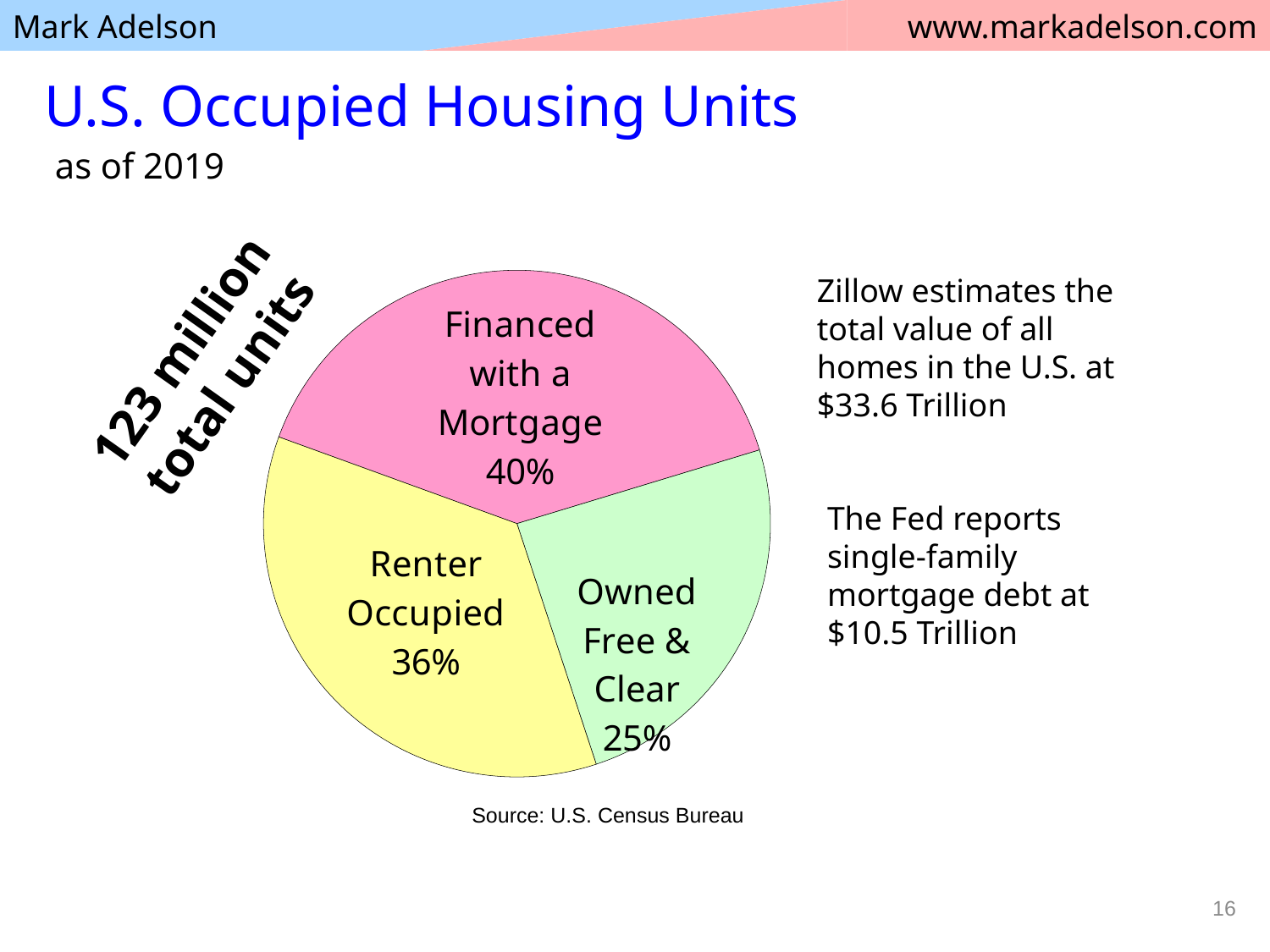
Which slice of the pie chart is the smallest? Owned Free & Clear What share of U.S. occupied housing units is financed with a mortgage? 40% What is the difference in percentage points between the Financed with a Mortgage slice and the Owned Free & Clear slice? 15 percentage points What is the difference in percentage points between the Financed with a Mortgage slice and the Renter Occupied slice? 4 percentage points What kind of chart is shown on the slide? Pie chart How many slices does the pie chart have? 3 What share of U.S. occupied housing units is owned free and clear? 25% What colour is the Renter Occupied slice of the pie chart? Yellow Which slice of the pie chart is the largest? Financed with a Mortgage What share of U.S. occupied housing units is renter occupied? 36% What is the title of the chart on the slide? U.S. Occupied Housing Units Which is larger: the Renter Occupied slice or the Owned Free & Clear slice? Renter Occupied